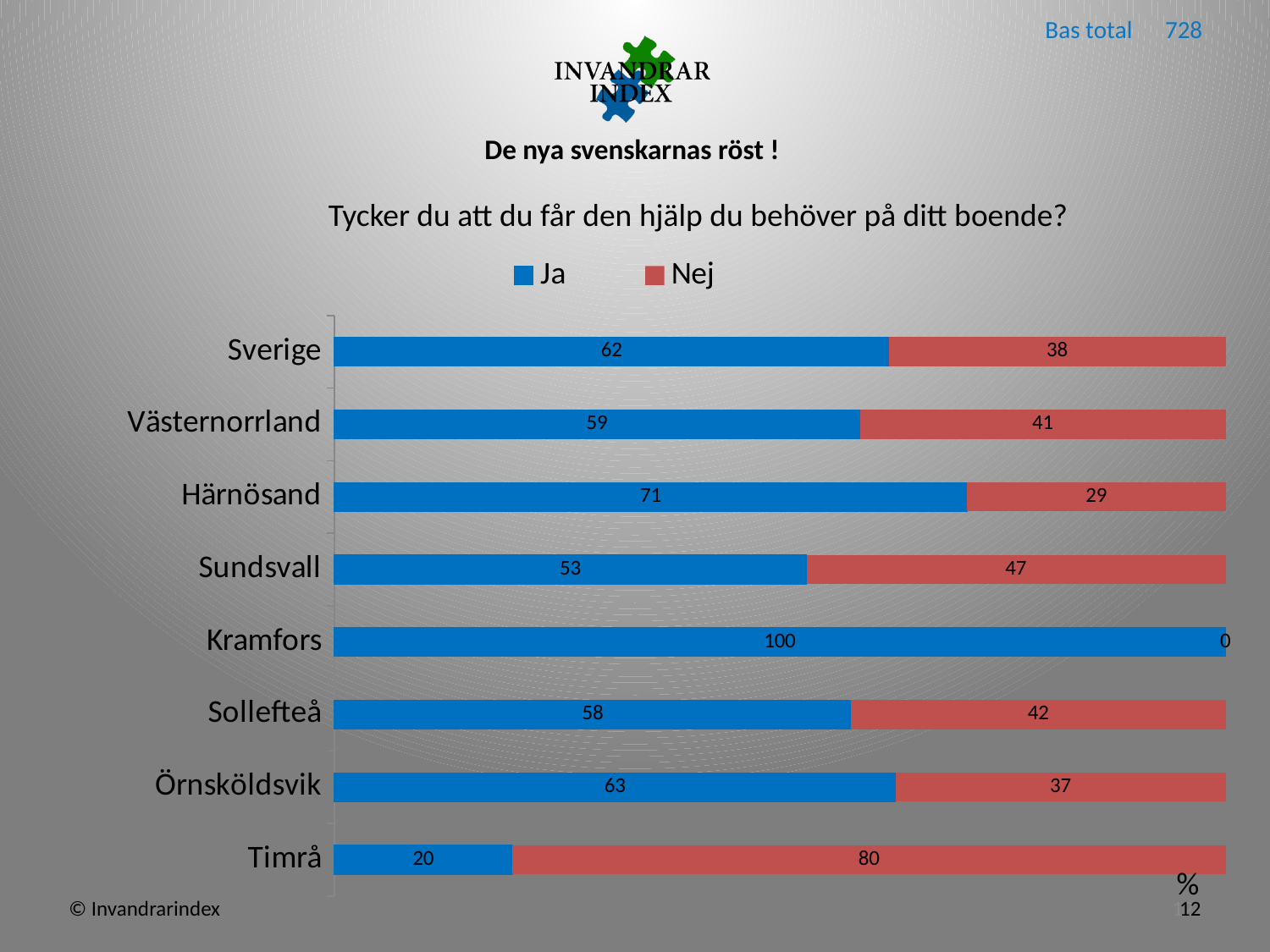
What is the total of the stacked bar for Sundsvall? 100 How many categories are shown on the chart? 8 What kind of chart is shown on the slide? Stacked bar chart What colour represents the "Nej" series? Red What is the "Nej" value for Timrå? 80 What is the difference between the "Ja" values for Sverige and Västernorrland? 3 Which category has the highest "Ja" value? Kramfors How many series does the legend list? 2 What is the "Ja" value for Härnösand? 71 Which is larger, the "Nej" value for Sollefteå or the "Nej" value for Örnsköldsvik? Sollefteå What is the "Nej" value for Sundsvall? 47 Which category has the lowest "Ja" value? Timrå